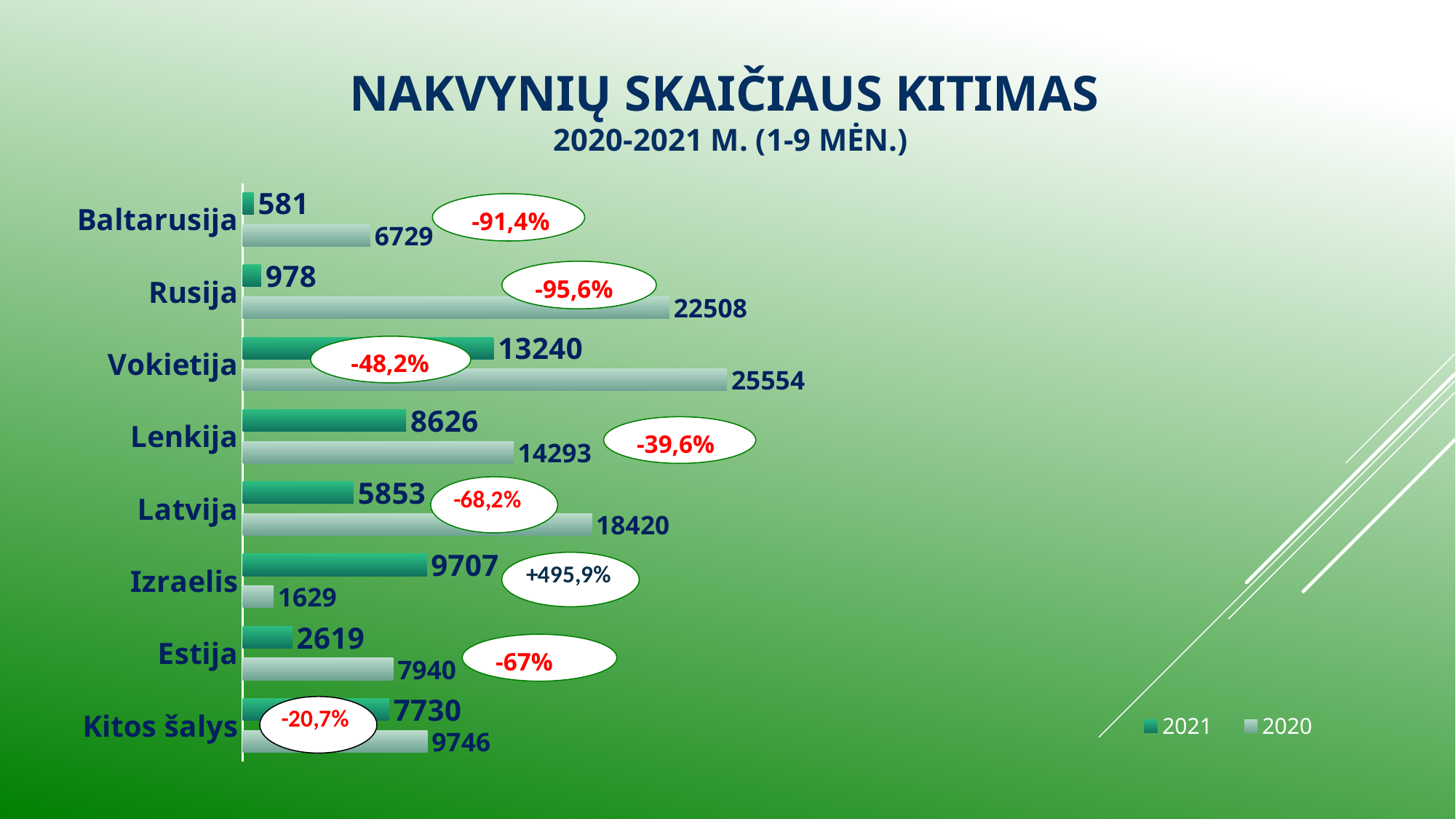
What is the 2021 value for Vokietija? 13240 Which category has the highest 2020 value? Vokietija What is the title of the chart? NAKVYNIŲ SKAIČIAUS KITIMAS 2020-2021 M. (1-9 MĖN.) How many categories are shown on the chart? 8 What is the 2020 value for Rusija? 22508 How many series does the legend list? 2 What percentage change is shown for Estija? -67% What is the difference between the 2020 and 2021 values for Latvija? 12567 What is the 2020 value for Izraelis? 1629 What kind of chart is shown on the slide? bar chart Which is larger for Izraelis, the 2021 value or the 2020 value? 2021 Which category has the lowest 2021 value? Baltarusija